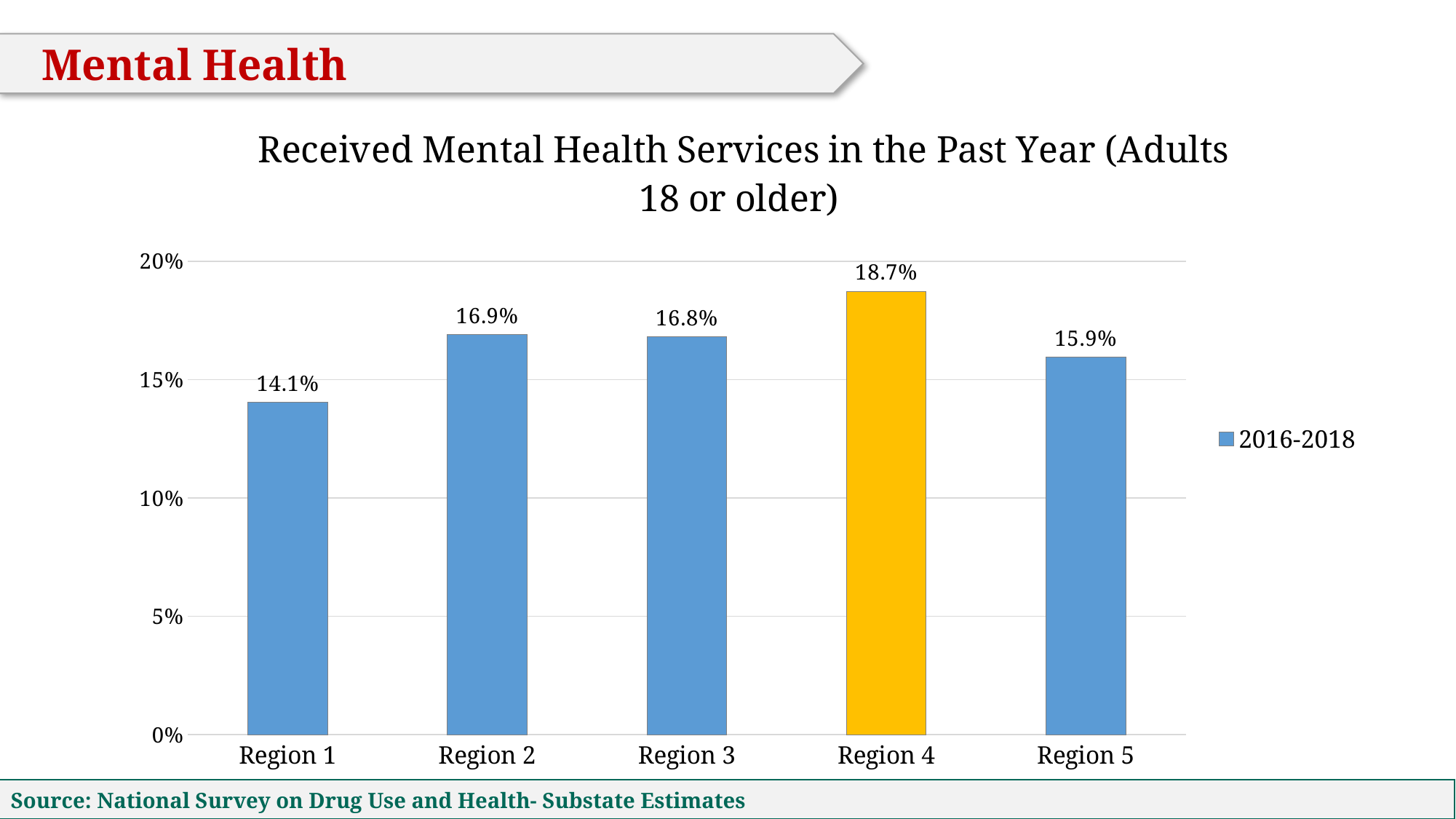
What kind of chart is shown on the slide? bar chart What is the value for Region 1? 14.1% What is the value for Region 4? 18.7% What is the difference between the values for Region 2 and Region 5? 1.0% Is the value for Region 3 greater or less than 15%? greater Which is larger, the value for Region 2 or the value for Region 5? Region 2 Which region has the highest value? Region 4 How many regions are shown on the chart? 5 What is the value for Region 5? 15.9% Which region has the lowest value? Region 1 What series does the legend list? 2016-2018 What is the difference between the values for Region 4 and Region 1? 4.6%